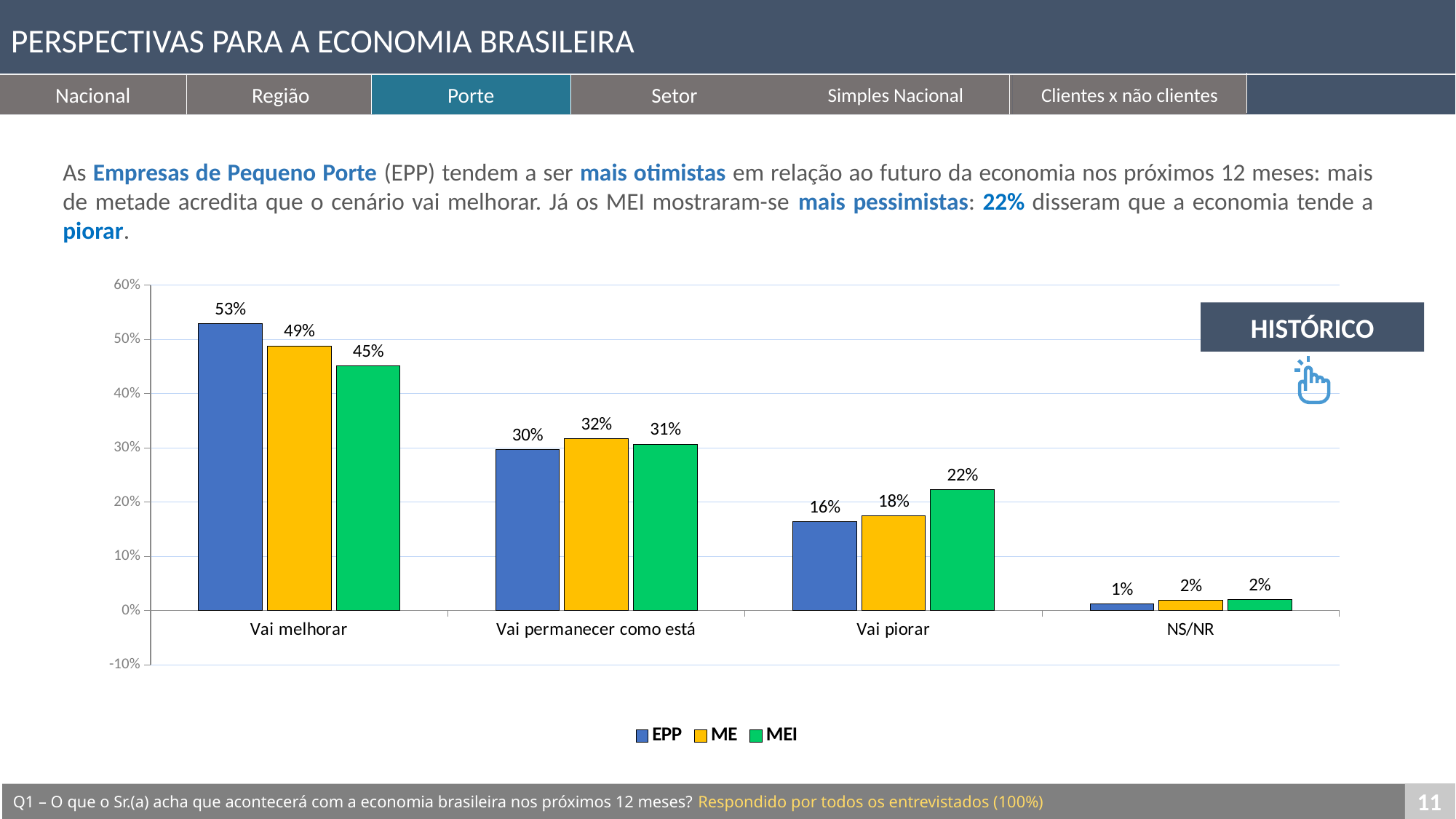
What is the value for MEI in the 'Vai piorar' category? 22% What kind of chart is shown on the slide? Bar chart Is the value for ME in the 'Vai melhorar' category greater or less than 40%? greater What is the value for EPP in the 'Vai melhorar' category? 53% What is the value for ME in the 'Vai permanecer como está' category? 32% Which series has the highest value in the 'Vai melhorar' category? EPP What is the difference between the EPP and MEI values in the 'Vai melhorar' category? 8% Which colour represents the MEI series in the chart? Green Which is larger in the 'Vai piorar' category: the value for EPP or the value for MEI? MEI How many series does the legend list? 3 Which category has the lowest values for all three series? NS/NR How many categories are shown on the x axis? 4